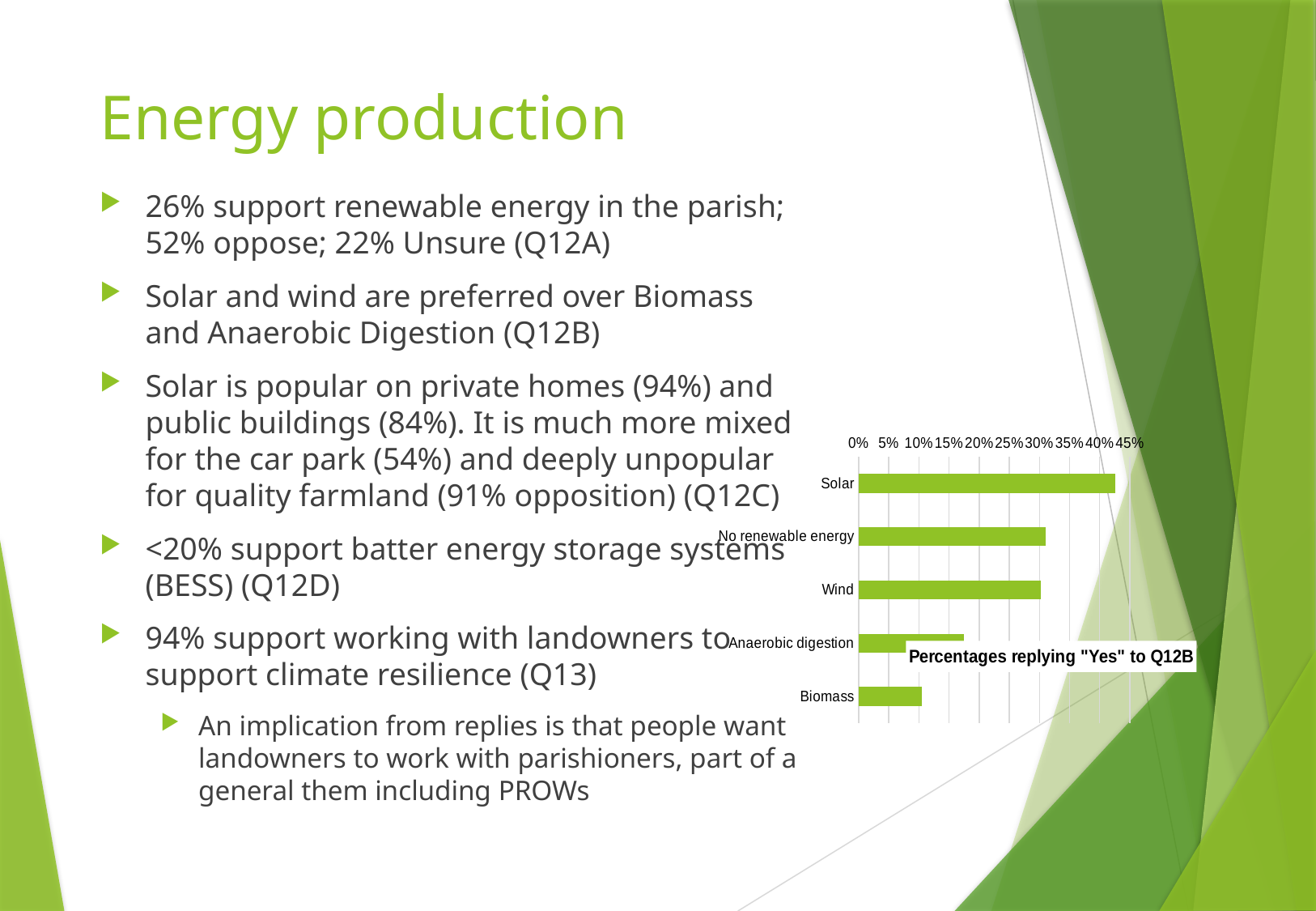
Is the value for Solar greater or less than 40%? greater Is the value for Anaerobic digestion greater or less than 20%? less Which is larger, the value for Anaerobic digestion or the value for Biomass? Anaerobic digestion Which category has the highest percentage replying "Yes" to Q12B? Solar Which category has the lowest percentage replying "Yes" to Q12B? Biomass Is the value for No renewable energy greater or less than 25%? greater Which is larger, the value for Solar or the value for Biomass? Solar How many categories does the chart show? 5 What kind of chart is shown on the slide? bar chart What is the title of the chart? Percentages replying "Yes" to Q12B